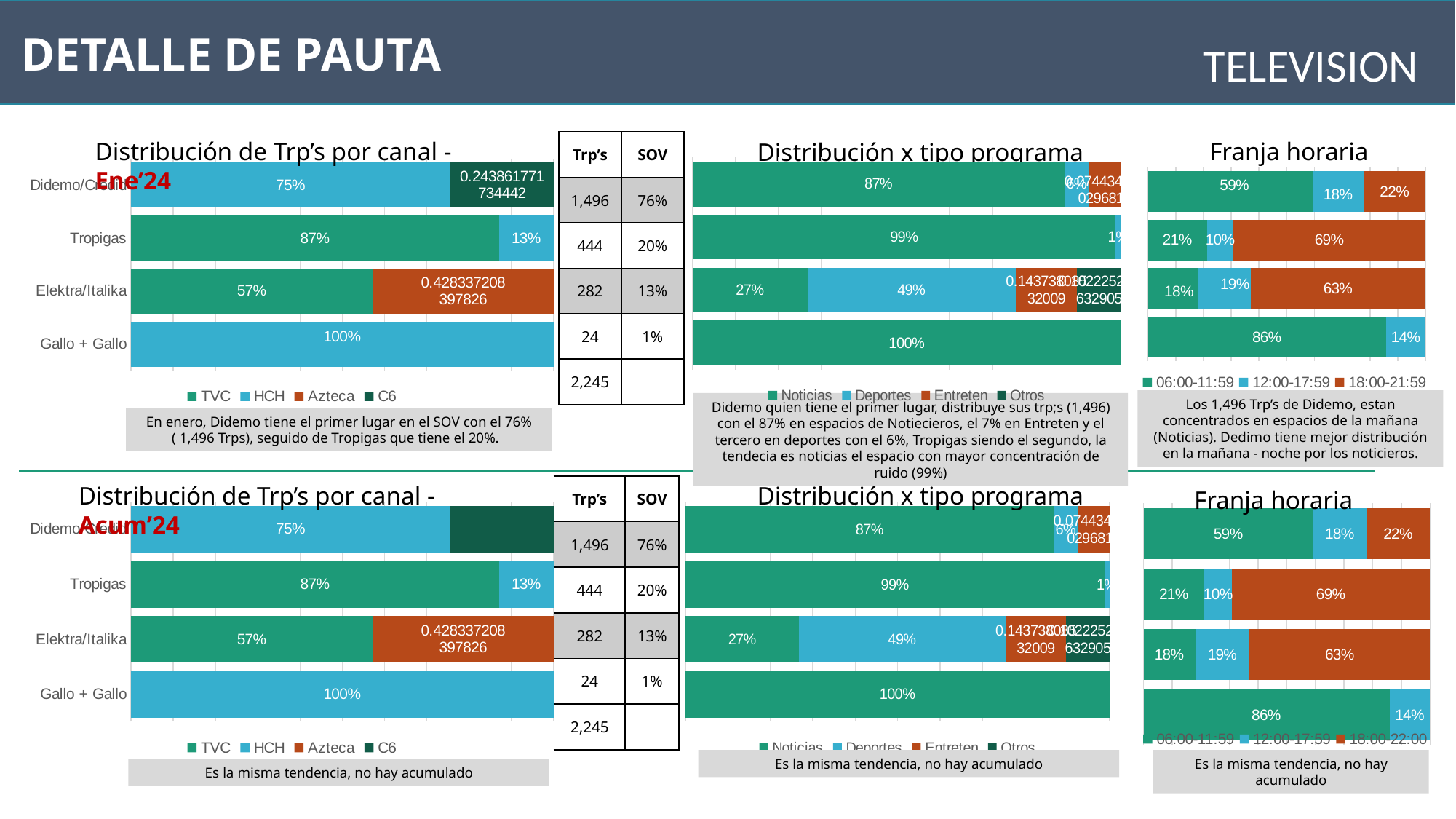
In the top-left chart 'Distribución de Trp's por canal - Ene'24', what is the TVC share for Tropigas? 87% In the top 'Distribución x tipo programa' chart (Ene'24 row), what is the Noticias share for Tropigas? 99% In the top 'Distribución x tipo programa' chart (Ene'24 row), what is the Deportes share for Elektra/Italika? 49% In the top-right 'Franja horaria' chart (Ene'24 row), what is the 12:00-17:59 share for Elektra/Italika? 19% In the top-right 'Franja horaria' chart (Ene'24 row), which category has the highest 06:00-11:59 share? Gallo + Gallo In the top-right 'Franja horaria' chart (Ene'24 row), what is the difference between the 18:00-21:59 share and the 12:00-17:59 share for the first category (Didemo)? 4 percentage points In the top-right 'Franja horaria' chart (Ene'24 row), what is the 18:00-21:59 share for Tropigas? 69% In the top 'Distribución x tipo programa' chart (Ene'24 row), which is larger for Elektra/Italika: Noticias or Deportes? Deportes How many series does the legend of the top-left chart 'Distribución de Trp's por canal - Ene'24' list? 4 In the bottom-left chart 'Distribución de Trp's por canal - Acum'24', what is the HCH share for Gallo + Gallo? 100% How many channel categories are shown in the top-left chart 'Distribución de Trp's por canal - Ene'24'? 4 What kind of chart is the top-left chart 'Distribución de Trp's por canal - Ene'24'? Bar chart